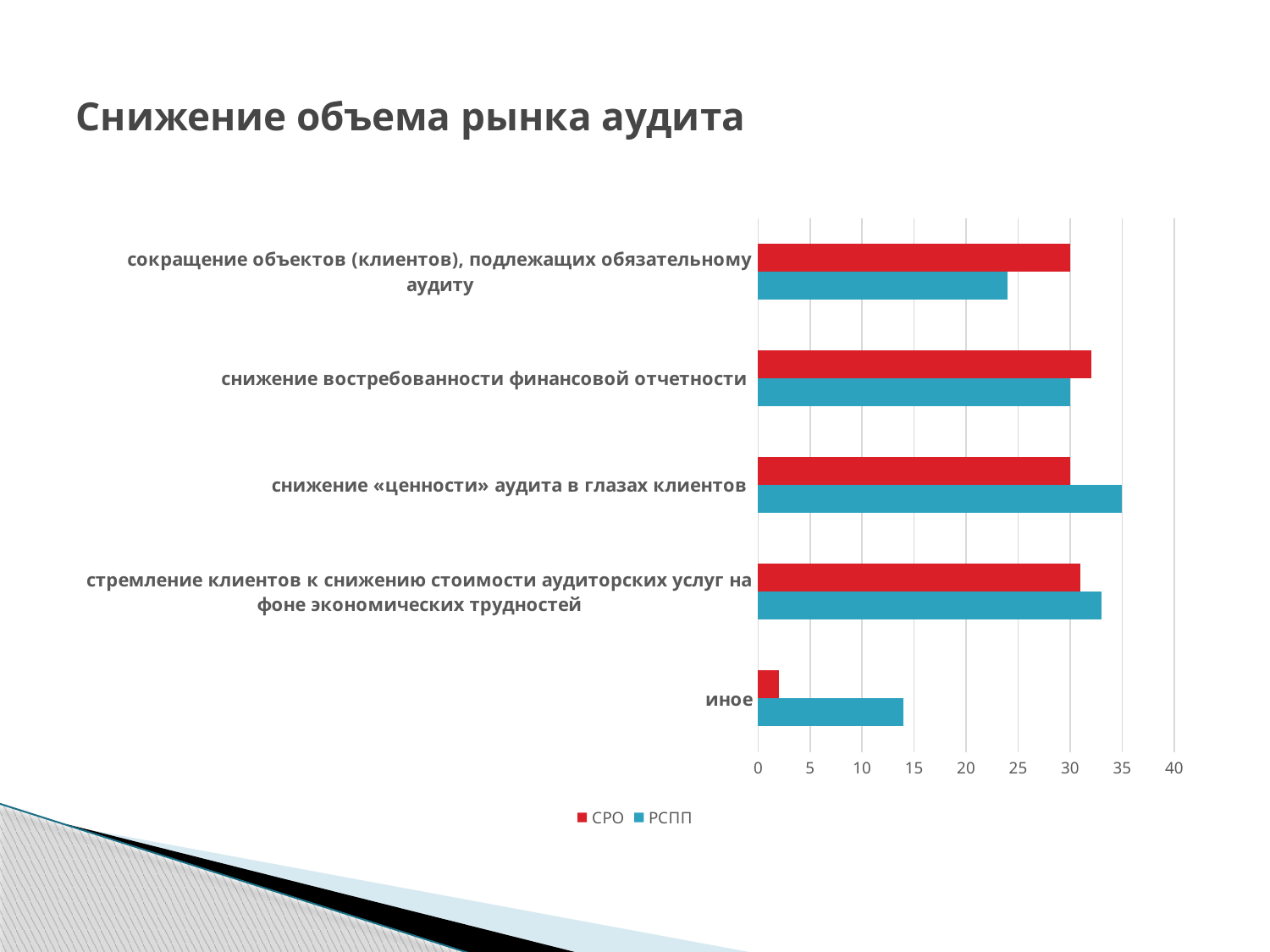
How many series does the legend list? 2 Which category has the lowest value for the РСПП series? иное Which category has the lowest value for the СРО series? иное What is the title of the chart slide? Снижение объема рынка аудита Is the РСПП value for «сокращение объектов (клиентов), подлежащих обязательному аудиту» greater or less than 25? less For «снижение «ценности» аудита в глазах клиентов», which series has the larger value, СРО or РСПП? РСПП Is the РСПП value for «иное» greater or less than 10? greater Which series is shown in red? СРО What kind of chart is shown on the slide? bar chart Is the СРО value for «иное» greater or less than 5? less How many categories are shown on the chart? 5 For «иное», which series has the larger value, СРО or РСПП? РСПП